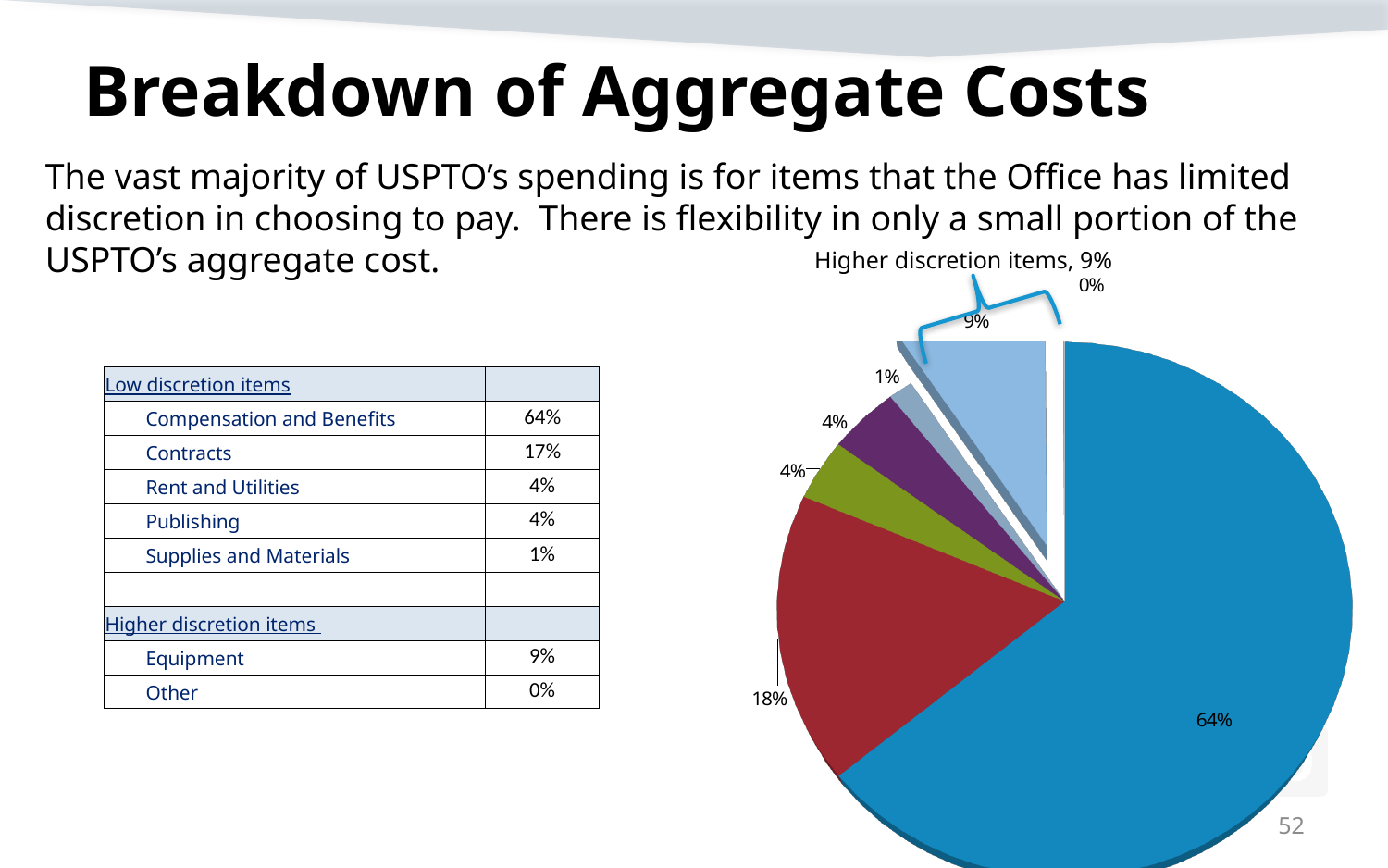
What type of chart is shown on the slide? pie chart What is the percentage shown on the light blue exploded slice of the pie chart? 9% How many slices are labelled with percentages on the pie chart? 7 According to the slide, what share of aggregate costs is Compensation and Benefits? 64% What is the difference in percentage points between the 64% slice and the 18% slice of the pie chart? 46 Which slice of the pie chart is larger, the dark blue slice or the red slice? the dark blue slice What is the smallest percentage labelled on the pie chart? 0% What does the bracket annotation above the pie chart say? Higher discretion items, 9% What is the percentage shown on the red slice of the pie chart? 18% What is the combined percentage of the two slices each labelled 4% on the pie chart? 8% What is the percentage shown on the largest slice of the pie chart? 64% Does the pie chart include a legend? No